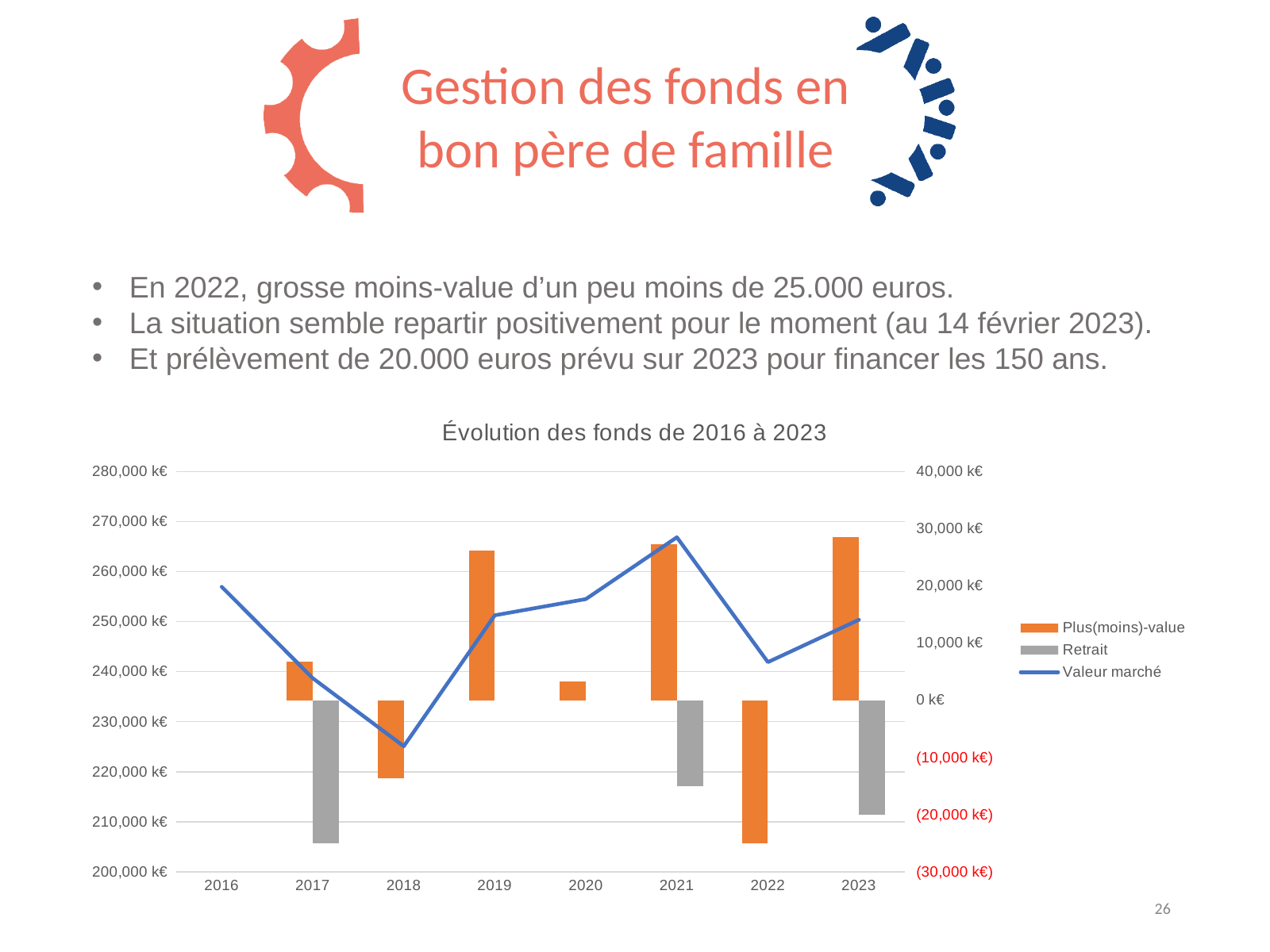
What is the title of the chart? Évolution des fonds de 2016 à 2023 Is the Plus(moins)-value for 2019 greater or less than 20,000 k€? greater How many years are shown on the x axis? 8 Is the Plus(moins)-value for 2022 greater or less than (20,000 k€)? less What kind of chart is shown on the slide? A combined bar and line chart In which year does the Valeur marché line reach its lowest point? 2018 In which year does the Valeur marché line reach its highest point? 2021 Does the Valeur marché line rise or fall from 2018 to 2021? rise In which year is the Plus(moins)-value bar the lowest? 2022 How many series does the legend list? 3 Is the Valeur marché for 2018 greater or less than 230,000 k€? less Which year has the higher Valeur marché, 2016 or 2022? 2016